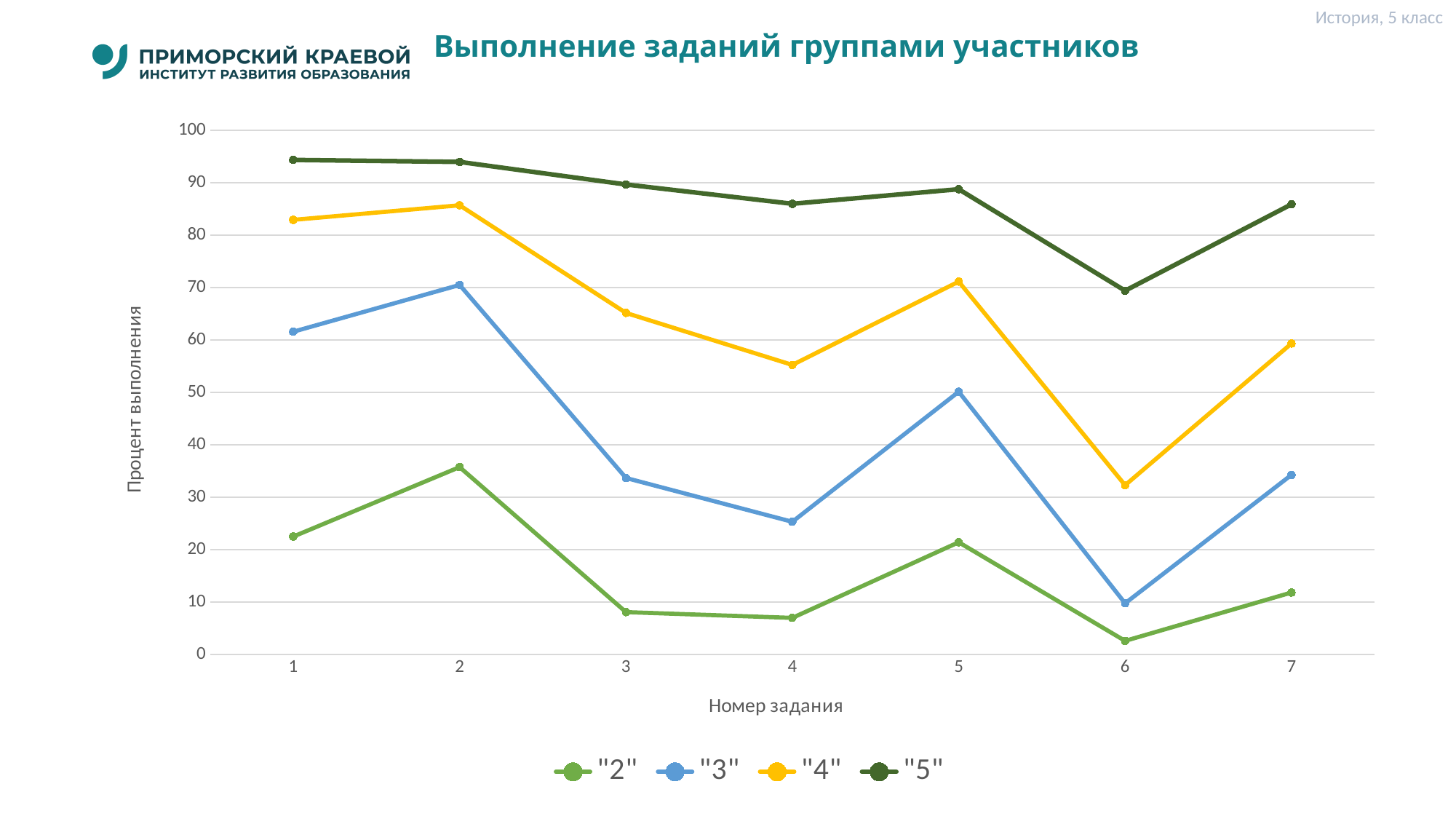
Does the series "5" rise or fall from task 1 to task 4? fall What kind of chart is shown on the slide? line chart What is the title of the x axis? Номер задания Is the value for series "5" at task 1 greater or less than 90? greater Is the value for series "3" at task 4 greater or less than 30? less How many tasks (points) are plotted along the x axis? 7 Is the value for series "4" at task 6 greater or less than 40? less For the series "5", which task number has the lowest value? 6 How many series does the legend list? 4 For the series "2", which task number has the highest value? 2 At task 5, which series has the larger value: "3" or "4"? "4" For the series "3", which task number has the lowest value? 6